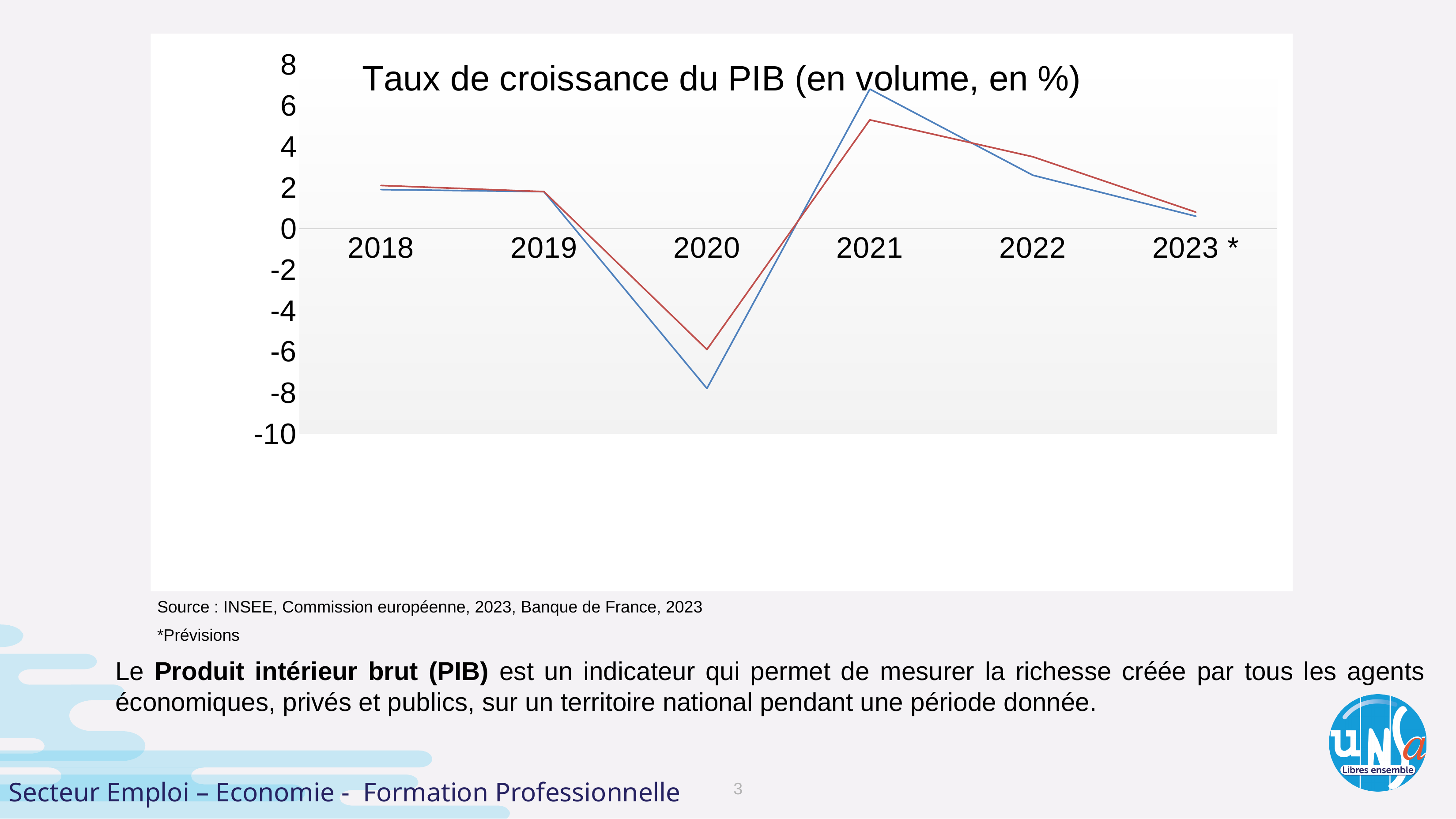
What kind of chart is shown on the slide? line chart In which year does the blue line reach its lowest value? 2020 How many years are shown on the x axis of the chart? 6 In which year does the blue line reach its highest value? 2021 What is the title of the chart? Taux de croissance du PIB (en volume, en %) In 2022, which line has the higher value, the blue line or the red line? red line Is the value of the blue line in 2020 greater or less than -6? less Is the value of the red line in 2021 greater or less than 4? greater In 2020, which line has the lower value, the blue line or the red line? blue line Is the value of the blue line in 2021 greater or less than 6? greater In which year does the red line reach its lowest value? 2020 Do the values of both lines rise or fall from 2021 to 2023 *? fall